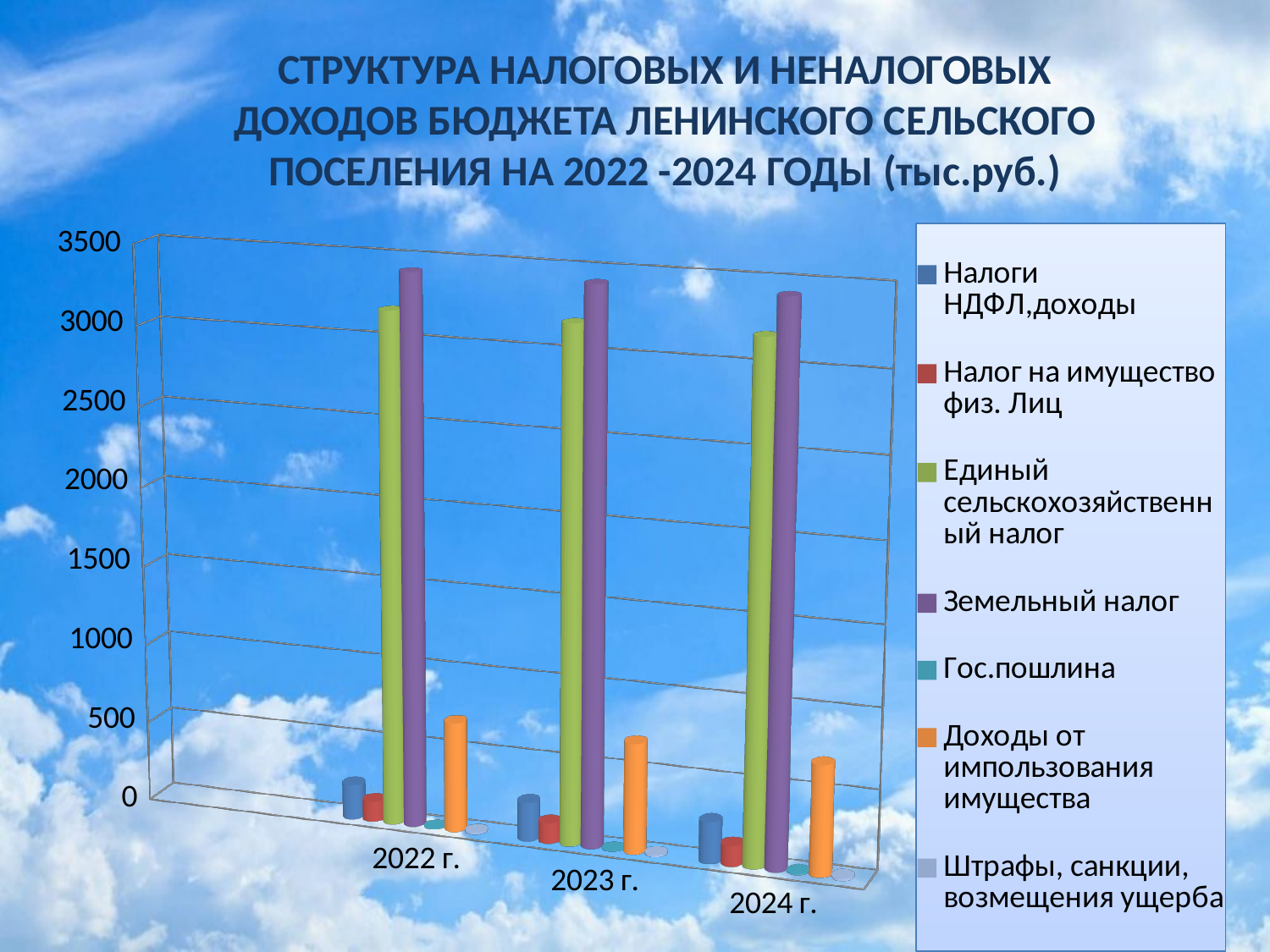
In 2023 г., which is larger: Земельный налог or Единый сельскохозяйственный налог? Земельный налог Is the value for Земельный налог in 2022 г. greater or less than 3000? greater What kind of chart is shown on the slide? bar chart In 2022 г., which is larger: Доходы от импользования имущества or Налог на имущество физ. Лиц? Доходы от импользования имущества How many years (categories) are shown on the x axis of the chart? 3 Is the value for Налоги НДФЛ,доходы in 2022 г. greater or less than 500? less Which series has the highest value in 2024 г.? Земельный налог Which series has the highest value in 2022 г.? Земельный налог How many series does the chart legend list? 7